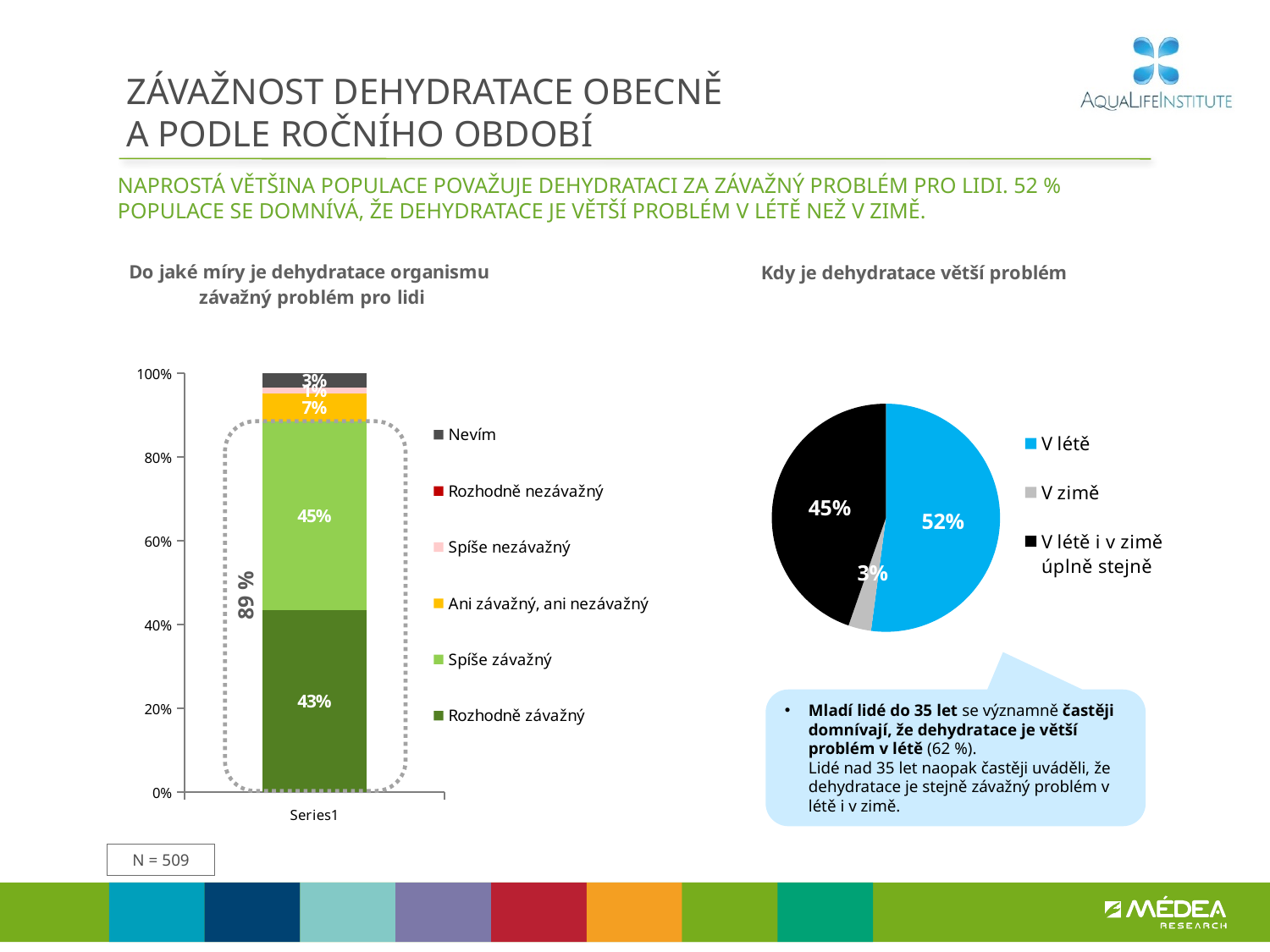
How many entries does the legend of the chart 'Do jaké míry je dehydratace organismu závažný problém pro lidi' list? 6 In the stacked bar chart 'Do jaké míry je dehydratace organismu závažný problém pro lidi', which is larger, 'Spíše závažný' or 'Rozhodně závažný'? Spíše závažný In the pie chart 'Kdy je dehydratace větší problém', what is the value for 'V létě'? 52% In the stacked bar chart 'Do jaké míry je dehydratace organismu závažný problém pro lidi', what is the value for 'Ani závažný, ani nezávažný'? 7% In the pie chart 'Kdy je dehydratace větší problém', which category has the smallest share? V zimě What kind of chart is 'Do jaké míry je dehydratace organismu závažný problém pro lidi'? Stacked bar chart In the pie chart 'Kdy je dehydratace větší problém', which category has the largest share? V létě In the stacked bar chart 'Do jaké míry je dehydratace organismu závažný problém pro lidi', what is the value for 'Spíše závažný'? 45% In the pie chart 'Kdy je dehydratace větší problém', what is the value for 'V zimě'? 3% How many slices does the pie chart 'Kdy je dehydratace větší problém' have? 3 In the stacked bar chart 'Do jaké míry je dehydratace organismu závažný problém pro lidi', what is the value for 'Rozhodně závažný'? 43% In the pie chart 'Kdy je dehydratace větší problém', how many percentage points larger is 'V létě' than 'V létě i v zimě úplně stejně'? 7